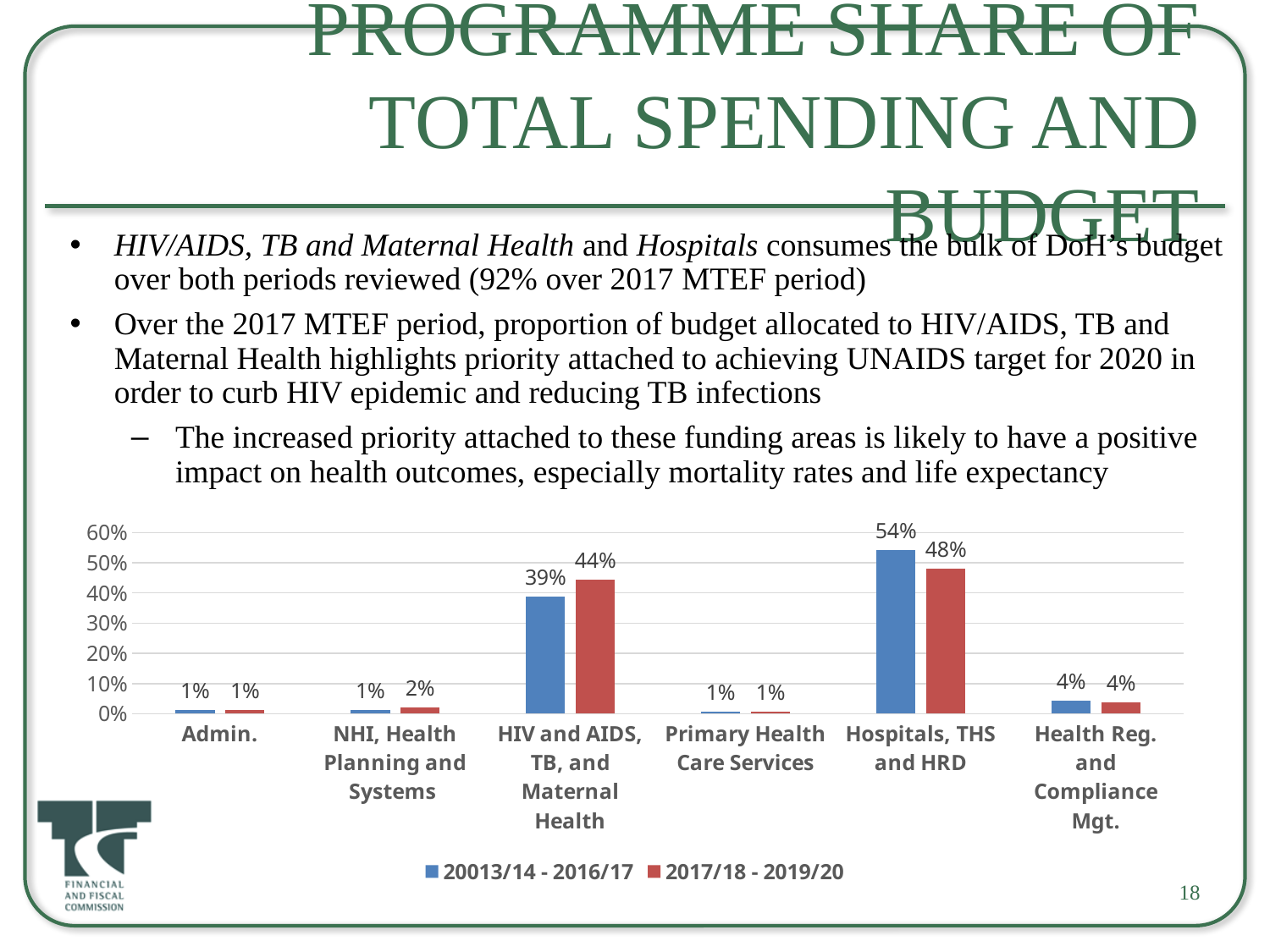
How many categories are shown on the x axis of the chart? 6 What is the difference between the 2017/18 - 2019/20 and 20013/14 - 2016/17 values for HIV and AIDS, TB, and Maternal Health? 5% What is the value for Hospitals, THS and HRD in the 2017/18 - 2019/20 series? 48% What is the value for Health Reg. and Compliance Mgt. in the 20013/14 - 2016/17 series? 4% How many series does the chart's legend list? 2 Which category has the highest value in the 20013/14 - 2016/17 series? Hospitals, THS and HRD What is the value for NHI, Health Planning and Systems in the 2017/18 - 2019/20 series? 2% What kind of chart is shown on the slide? Bar chart What is the difference between the 20013/14 - 2016/17 and 2017/18 - 2019/20 values for Hospitals, THS and HRD? 6% For HIV and AIDS, TB, and Maternal Health, which series has the larger value: 20013/14 - 2016/17 or 2017/18 - 2019/20? 2017/18 - 2019/20 Which category has the highest value in the 2017/18 - 2019/20 series? Hospitals, THS and HRD What is the value for HIV and AIDS, TB, and Maternal Health in the 20013/14 - 2016/17 series? 39%